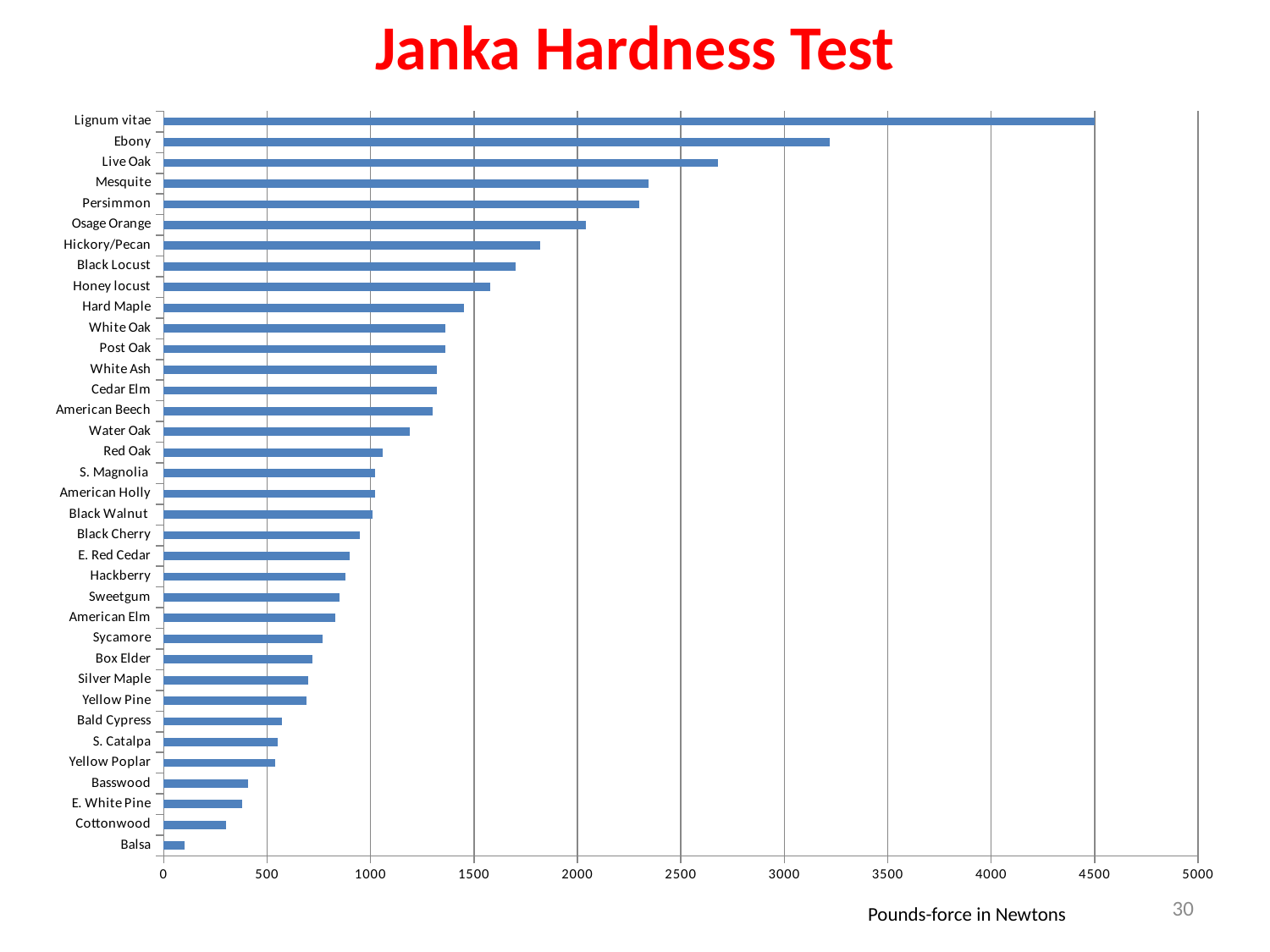
Which has the larger value, Ebony or Live Oak? Ebony What kind of chart is shown on the slide? bar chart How many woods are listed on the chart? 36 Is the value for Hard Maple greater or less than 1500? less Is the value for Balsa greater or less than 500? less Is the value for Black Locust greater or less than 1500? greater Which wood has the highest Janka hardness value? Lignum vitae What is the label shown under the horizontal axis? Pounds-force in Newtons Which has the larger value, Cottonwood or Basswood? Basswood Which wood has the lowest Janka hardness value? Balsa